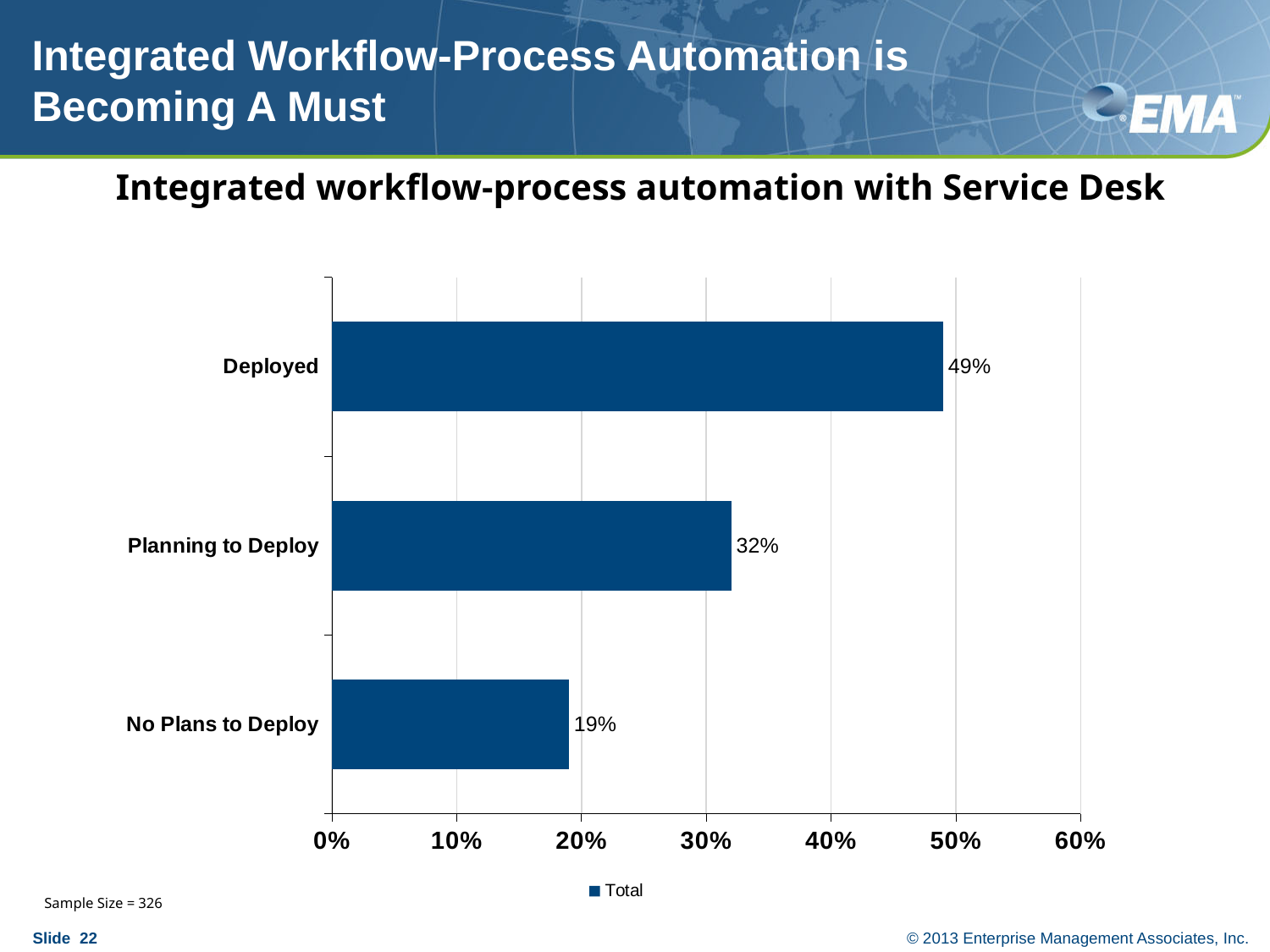
Which category has the highest value? Deployed Is the value for Deployed greater or less than 40%? greater How many categories are shown in the chart? 3 What is the value for No Plans to Deploy? 19% Which is larger, the value for Planning to Deploy or the value for No Plans to Deploy? Planning to Deploy What is the value for Deployed? 49% What is the difference between the values for Planning to Deploy and No Plans to Deploy? 13% What is the value for Planning to Deploy? 32% What kind of chart is shown on the slide? bar chart What is the title of the chart? Integrated workflow-process automation with Service Desk What is the difference between the values for Deployed and Planning to Deploy? 17% Which category has the lowest value? No Plans to Deploy